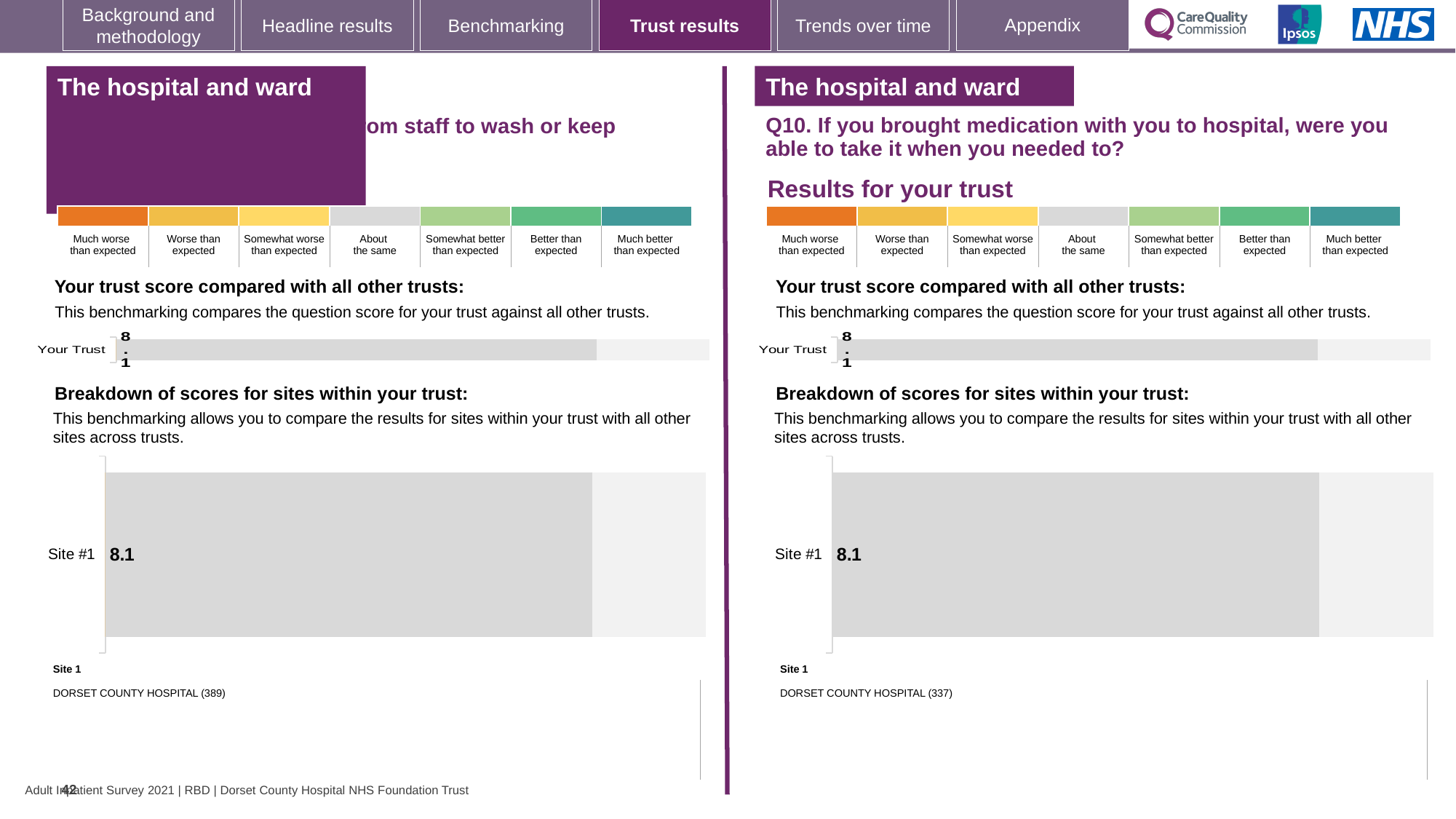
On the right-hand chart for Q10, is the Site #1 score the same as the Your Trust score? yes On the right-hand chart for Q10, what is the score shown for Your Trust? 8.1 On the right-hand chart for Q10, what score is shown for Site #1 in the breakdown of scores for sites within your trust? 8.1 On the left-hand chart, is the Site #1 score greater or less than 5? greater What kind of chart is used to show the Site #1 score on the right-hand side of the slide? bar chart On the left-hand chart, what score is shown for Site #1 in the breakdown of scores for sites within your trust? 8.1 How many rating categories are shown in the colour scale above the right-hand chart, from 'Much worse than expected' to 'Much better than expected'? 7 On the left-hand chart, what is the score shown for Your Trust? 8.1 On the right-hand side of the slide, which hospital is listed as Site 1? DORSET COUNTY HOSPITAL (337) On the right-hand chart for Q10, how many sites are shown in the breakdown of scores for sites within your trust? 1